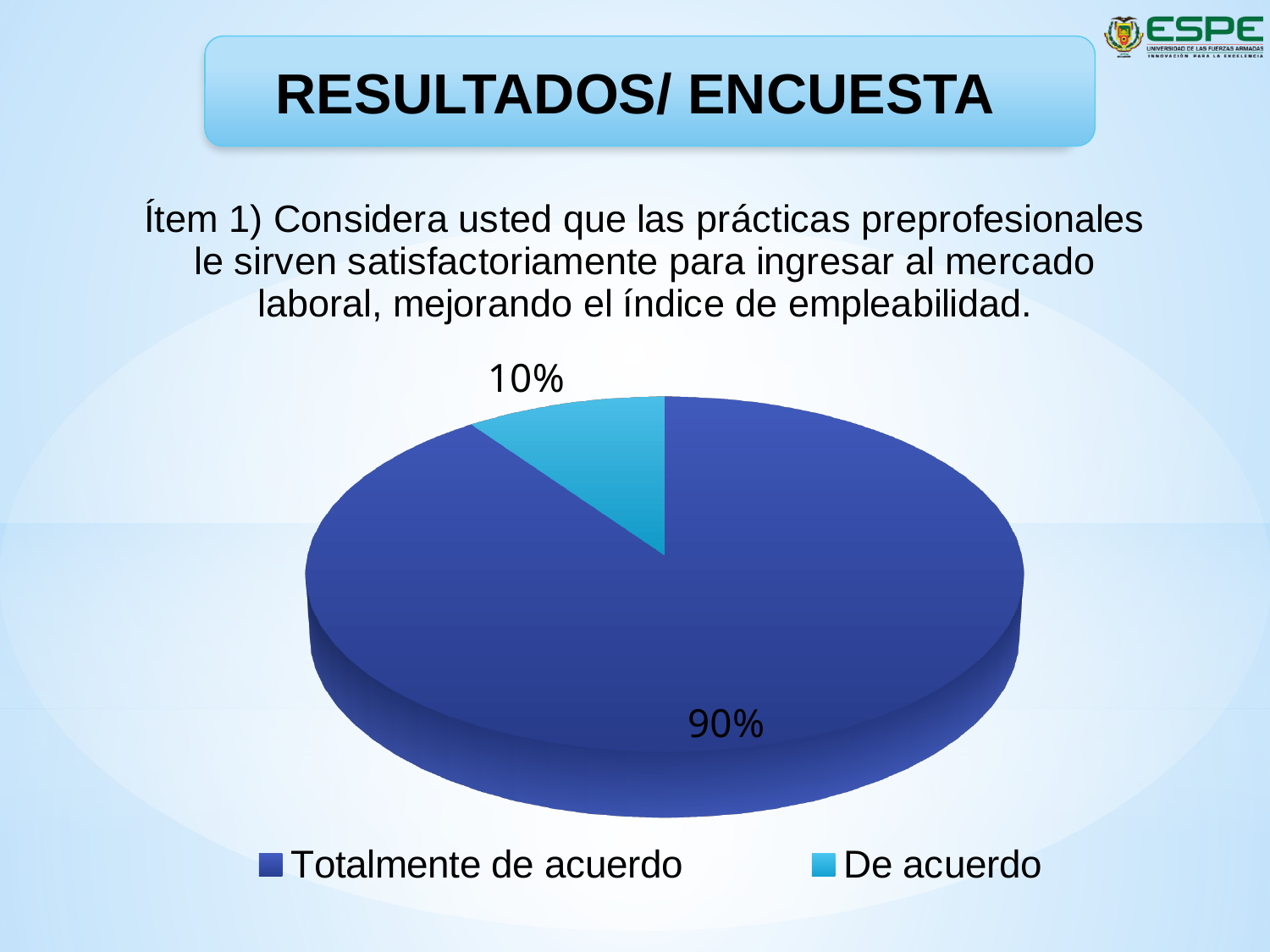
How many categories does the pie chart show? 2 What share of the pie does "Totalmente de acuerdo" represent? 90% What colour is the slice for "De acuerdo"? Light blue Which category has the smallest slice of the pie? De acuerdo What share of the pie does "De acuerdo" represent? 10% Which is larger, the slice for "Totalmente de acuerdo" or the slice for "De acuerdo"? Totalmente de acuerdo What is the title shown at the top of the slide? RESULTADOS/ ENCUESTA How many entries does the legend list? 2 What is the difference in percentage points between "Totalmente de acuerdo" and "De acuerdo"? 80 What kind of chart is shown on the slide? Pie chart Which category has the largest slice of the pie? Totalmente de acuerdo